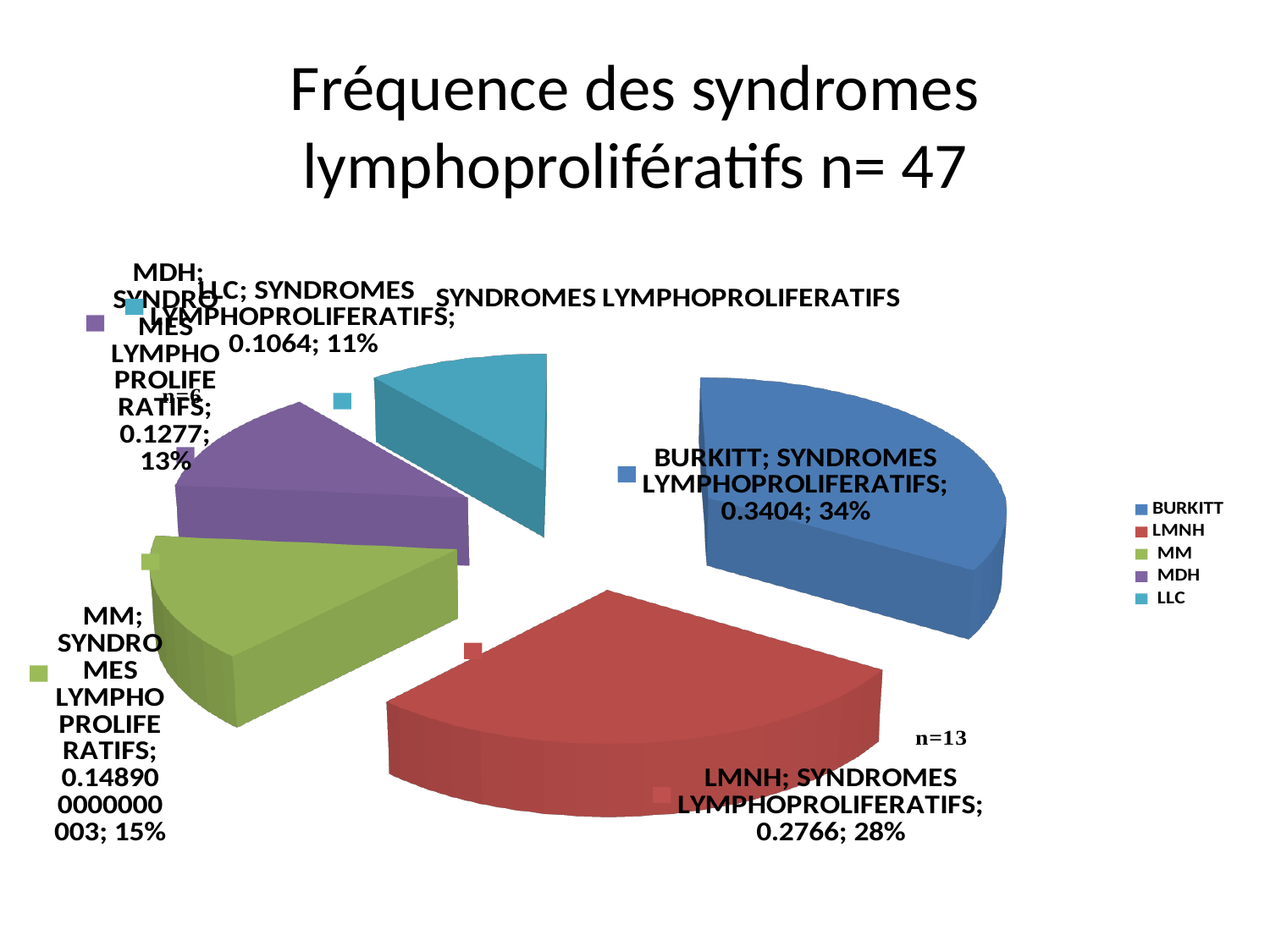
Which category has the smallest share of the pie? LLC What is the difference in percentage points between the BURKITT and LMNH shares? 6% What percentage share does the LLC slice have? 11% What kind of chart is shown on the slide? Pie chart Which category has the largest share of the pie? BURKITT What percentage share does the MM slice have? 15% What percentage share does the MDH slice have? 13% What is the value shown for LMNH as a decimal fraction? 0.2766 How many categories does the legend list? 5 Which has a larger share, MM or MDH? MM